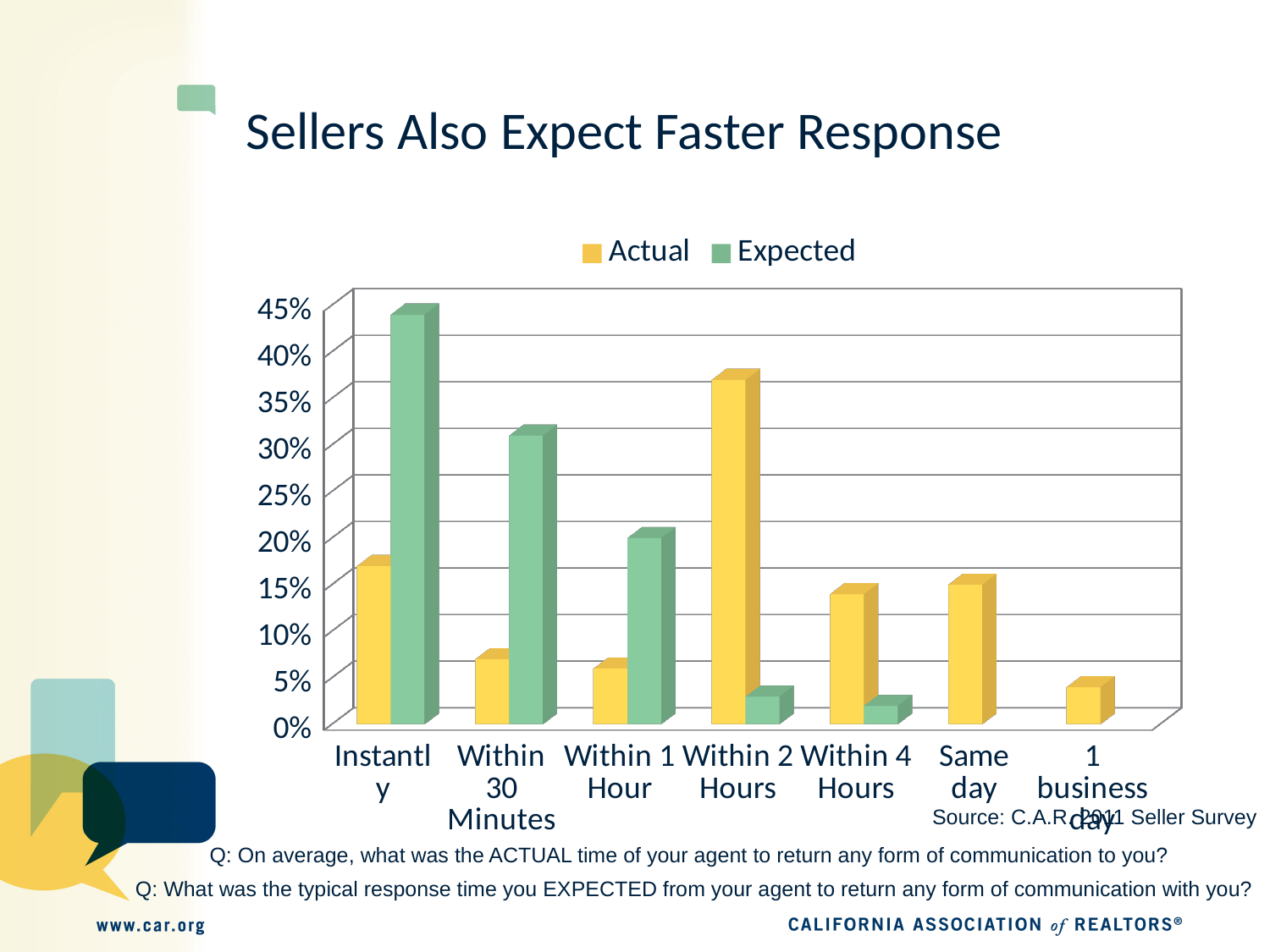
Is the Expected value for Instantly greater or less than 40%? greater What is the title of the chart on the slide? Sellers Also Expect Faster Response Which category has the highest Actual value? Within 2 Hours Is the Actual value for Within 30 Minutes greater or less than 10%? less What kind of chart is shown on the slide? bar chart Which category has the lowest Actual value? 1 business day For the Within 2 Hours category, which is larger, the Actual or the Expected value? Actual How many response-time categories are shown on the x axis? 7 For the Instantly category, which is larger, the Actual or the Expected value? Expected Which category has the highest Expected value? Instantly How many series does the legend list? 2 Is the Expected value for Within 1 Hour greater or less than 25%? less